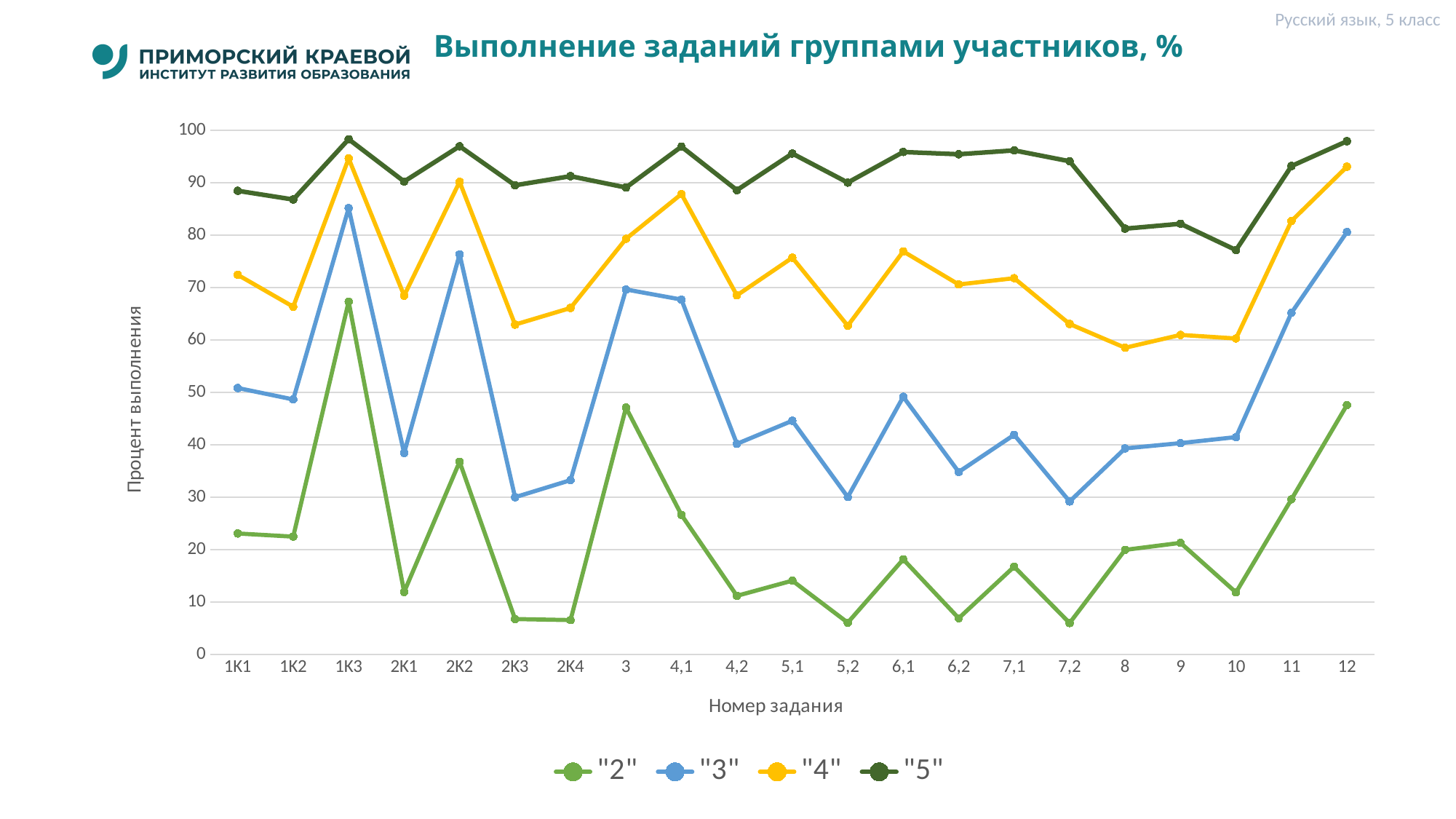
Is the value for series "3" at task 2К3 greater or less than 40? less How many task numbers are shown along the x axis? 21 Is the value for series "5" at task 10 greater or less than 80? less Is the value for series "4" at task 2К2 greater or less than 80? greater Which is larger for series "3": the value at task 2К2 or the value at task 3? 2К2 For series "5", which task has the lowest value? 10 What is the title of the chart? Выполнение заданий группами участников, % For series "2", which task has the highest value? 1К3 Does series "3" rise or fall from task 10 to task 12? rise How many series does the legend list? 4 What kind of chart is shown on the slide? line chart